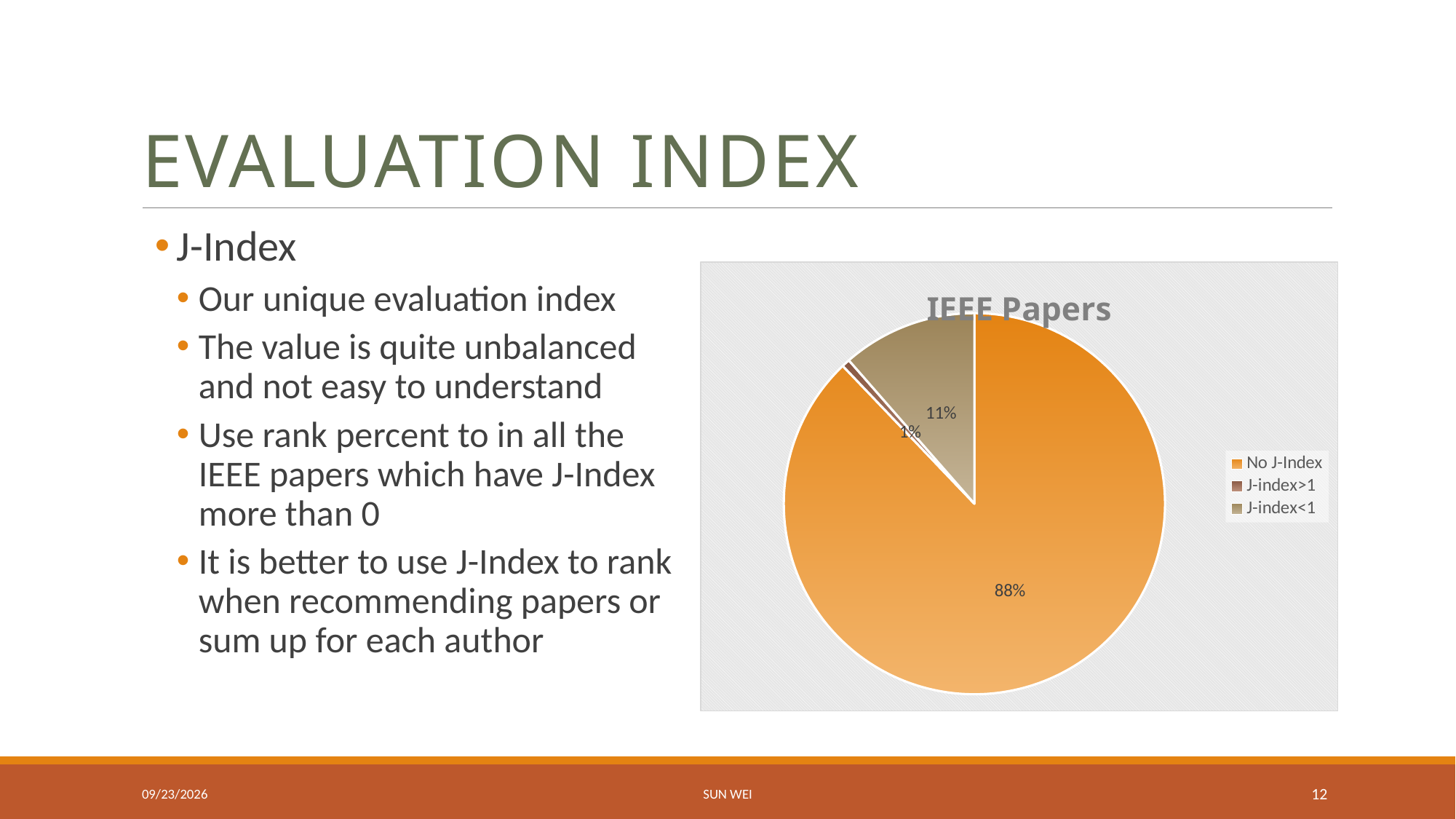
What type of chart is shown on the slide? Pie chart What share of the pie does the J-index<1 slice represent? 11% What colour is the No J-Index slice? Orange How many entries does the legend list? 3 Which category has the smallest slice of the pie? J-index>1 What share of the pie does the J-index>1 slice represent? 1% Which slice is larger, J-index<1 or J-index>1? J-index<1 What share of the pie does the No J-Index slice represent? 88% What is the difference in percentage points between the No J-Index slice and the J-index<1 slice? 77 What is the title of the chart? IEEE Papers Which category has the largest slice of the pie? No J-Index How many categories does the pie chart show? 3